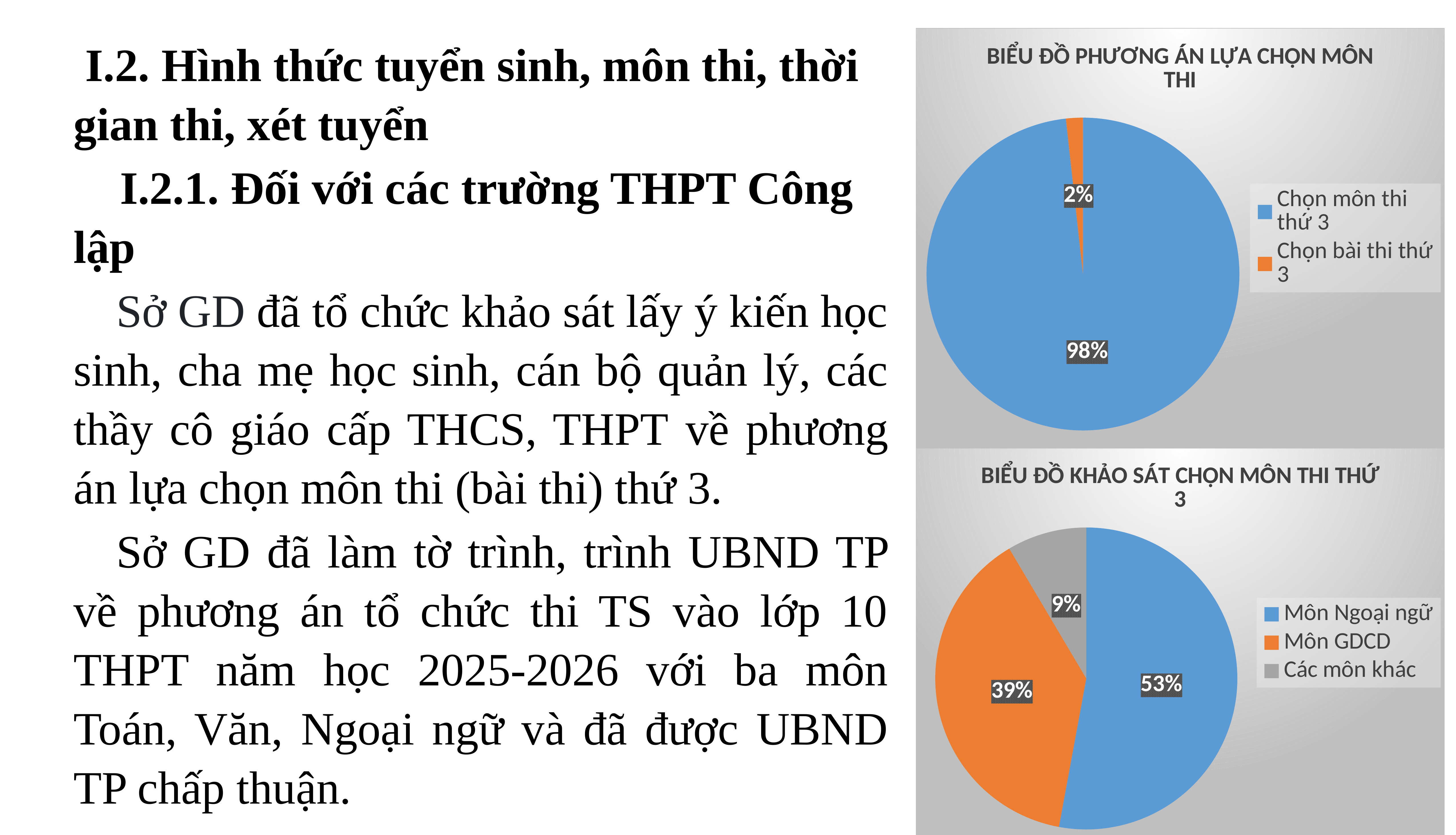
In the bottom chart (BIỂU ĐỒ KHẢO SÁT CHỌN MÔN THI THỨ 3), what share is labelled for 'Môn Ngoại ngữ'? 53% In the bottom chart (BIỂU ĐỒ KHẢO SÁT CHỌN MÔN THI THỨ 3), which is larger: 'Môn Ngoại ngữ' or 'Môn GDCD'? Môn Ngoại ngữ How many categories does the legend of the bottom chart (BIỂU ĐỒ KHẢO SÁT CHỌN MÔN THI THỨ 3) list? 3 In the top chart (BIỂU ĐỒ PHƯƠNG ÁN LỰA CHỌN MÔN THI), what share is labelled for 'Chọn bài thi thứ 3'? 2% What type of chart is the top chart (BIỂU ĐỒ PHƯƠNG ÁN LỰA CHỌN MÔN THI)? Pie chart In the bottom chart (BIỂU ĐỒ KHẢO SÁT CHỌN MÔN THI THỨ 3), what colour is the slice for 'Môn GDCD'? Orange In the top chart (BIỂU ĐỒ PHƯƠNG ÁN LỰA CHỌN MÔN THI), what is the difference in percentage points between 'Chọn môn thi thứ 3' and 'Chọn bài thi thứ 3'? 96 percentage points In the bottom chart (BIỂU ĐỒ KHẢO SÁT CHỌN MÔN THI THỨ 3), what share is labelled for 'Môn GDCD'? 39% In the top chart (BIỂU ĐỒ PHƯƠNG ÁN LỰA CHỌN MÔN THI), what share is labelled for 'Chọn môn thi thứ 3'? 98% In the bottom chart (BIỂU ĐỒ KHẢO SÁT CHỌN MÔN THI THỨ 3), which category has the smallest slice? Các môn khác In the bottom chart (BIỂU ĐỒ KHẢO SÁT CHỌN MÔN THI THỨ 3), what share is labelled for 'Các môn khác'? 9% In the top chart (BIỂU ĐỒ PHƯƠNG ÁN LỰA CHỌN MÔN THI), which option has the largest slice? Chọn môn thi thứ 3